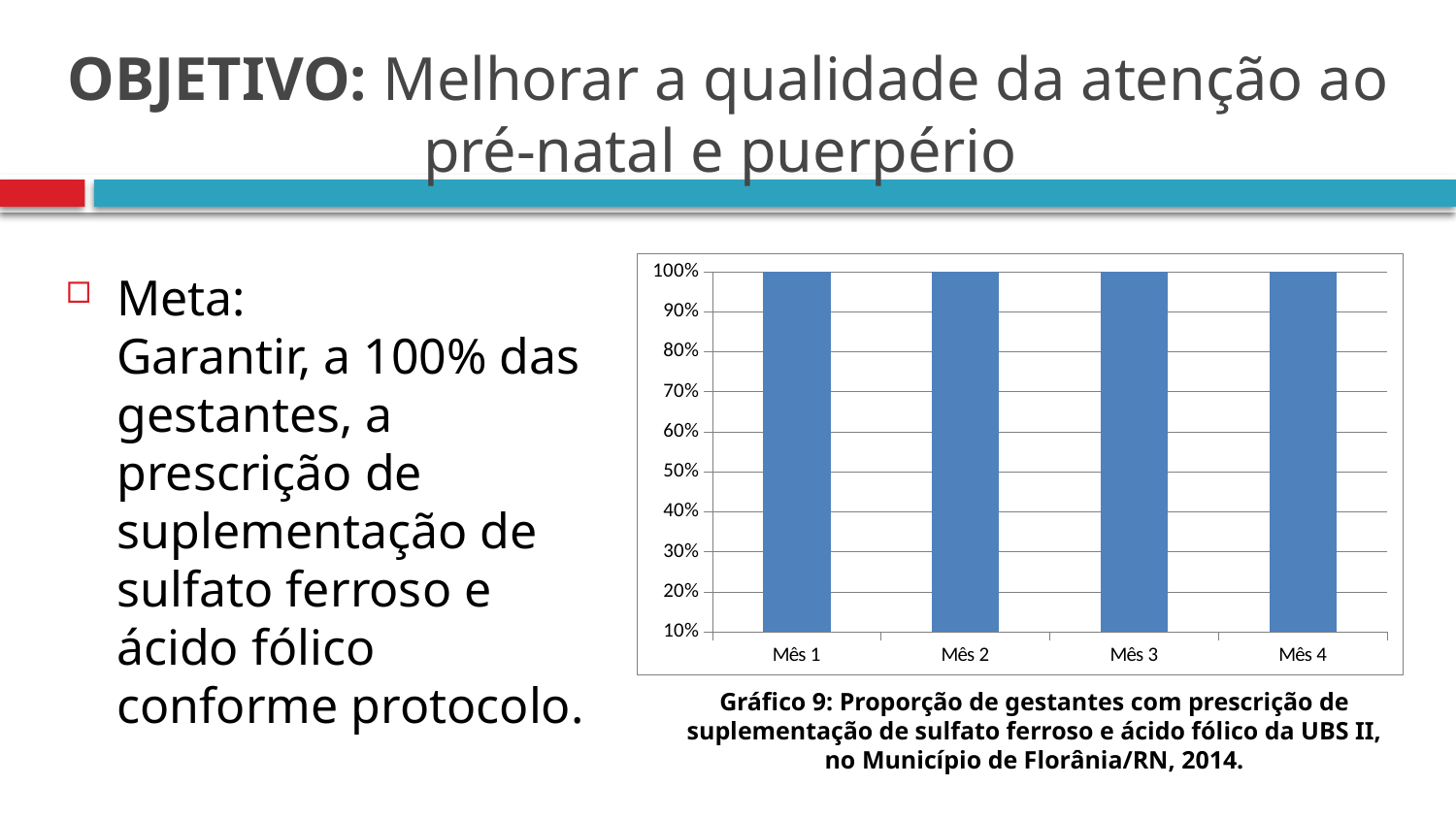
What kind of chart is shown on the slide? bar chart What is the value for Mês 2? 100% How many categories are shown on the x axis of the chart? 4 What is the value for Mês 1? 100% What is the value for Mês 3? 100% What is the difference between the values for Mês 1 and Mês 4? 0% What is the value for Mês 4? 100% Is the value for Mês 3 greater or less than 50%? greater What is the lowest value shown on the chart's vertical axis? 10% Do the values rise, fall or stay the same from Mês 1 to Mês 4? stay the same What is the number of the chart given in its caption (Gráfico)? Gráfico 9